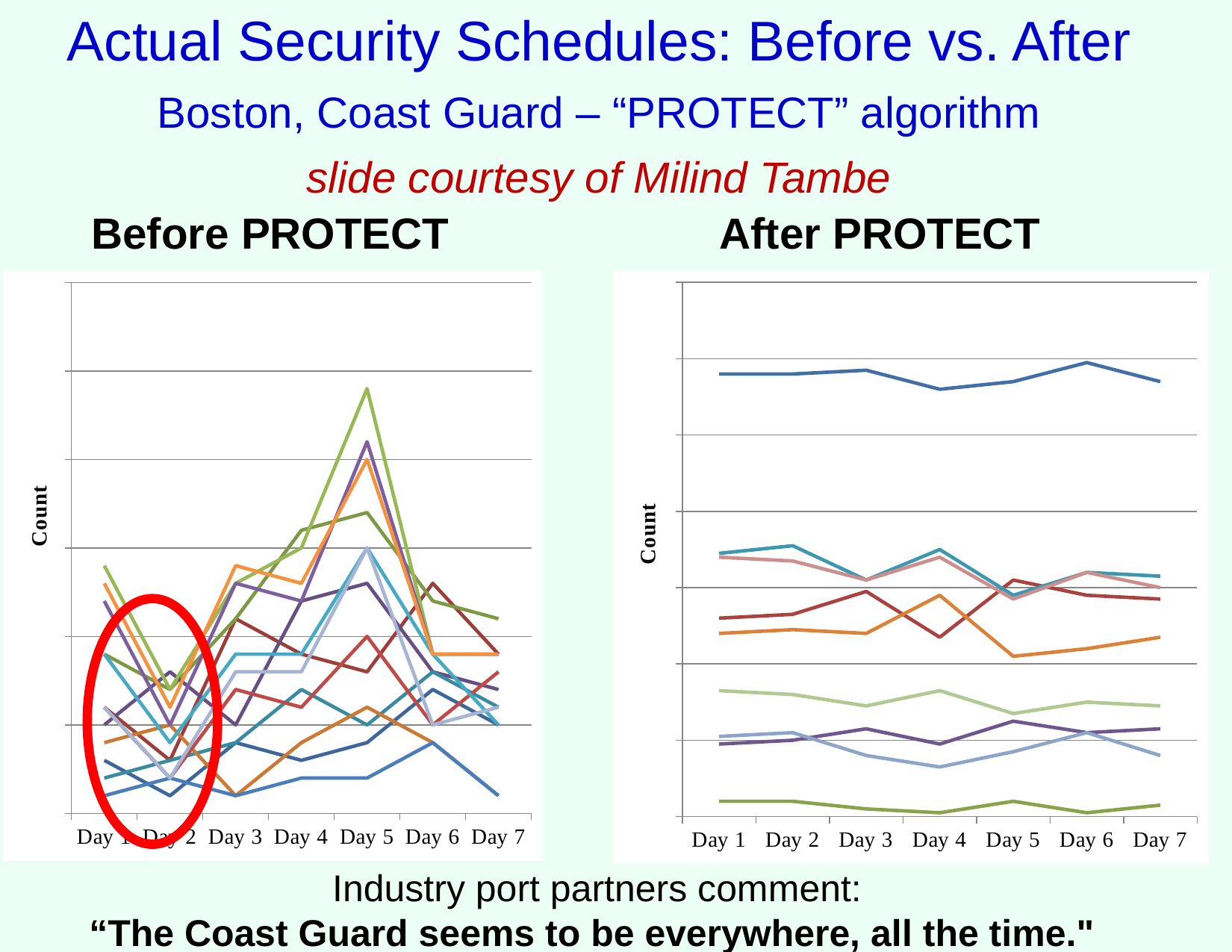
What kind of chart is the After PROTECT chart? line chart How many days are shown on the x axis of the After PROTECT chart? 7 Which days are circled in red on the Before PROTECT chart? Day 1 and Day 2 How many days are shown on the x axis of the Before PROTECT chart? 7 On the Before PROTECT chart, on which day does the highest point of any line occur? Day 5 On the After PROTECT chart, on which day does the topmost line reach its lowest point? Day 4 What is the y-axis label on the Before PROTECT chart? Count On the After PROTECT chart, does the topmost line reach a higher value on Day 4 or on Day 6? Day 6 What kind of chart is the Before PROTECT chart? line chart